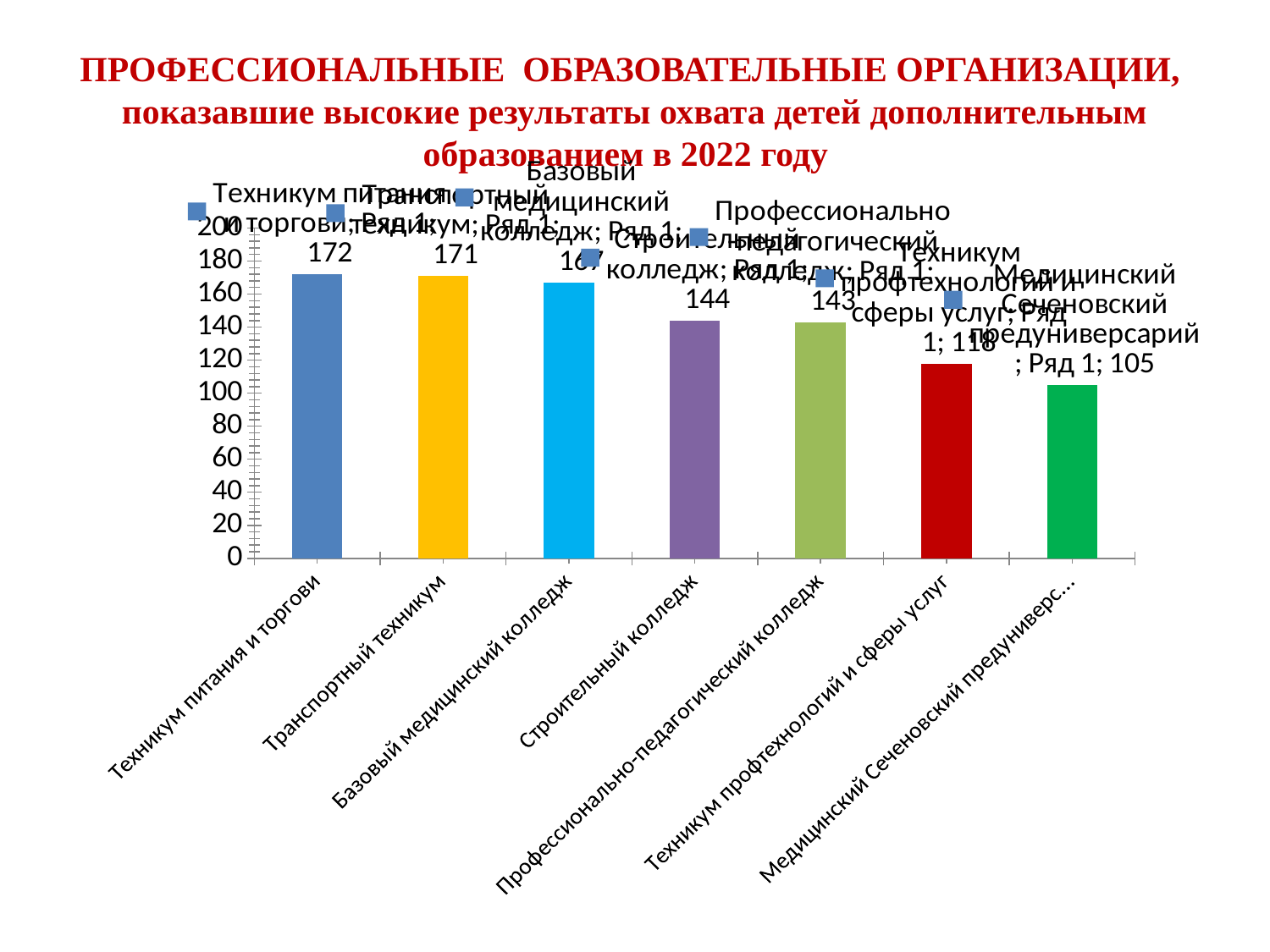
What is the value for Медицинский Сеченовский предуниверсарий? 105 Do the values rise or fall from left to right along the x axis? fall How many categories (organisations) are plotted in the chart? 7 What type of chart is shown on the slide? bar chart What is the value for Техникум профтехнологий и сферы услуг? 118 What is the value for Строительный колледж? 144 What is the difference between the values for Строительный колледж and Техникум профтехнологий и сферы услуг? 26 Which organisation has the lowest value in the chart? Медицинский Сеченовский предуниверсарий What is the value for Техникум питания и торгови? 172 Which is larger: the value for Транспортный техникум or the value for Профессионально-педагогический колледж? Транспортный техникум Is the value for Медицинский Сеченовский предуниверсарий greater or less than 120? less What is the value for Транспортный техникум? 171